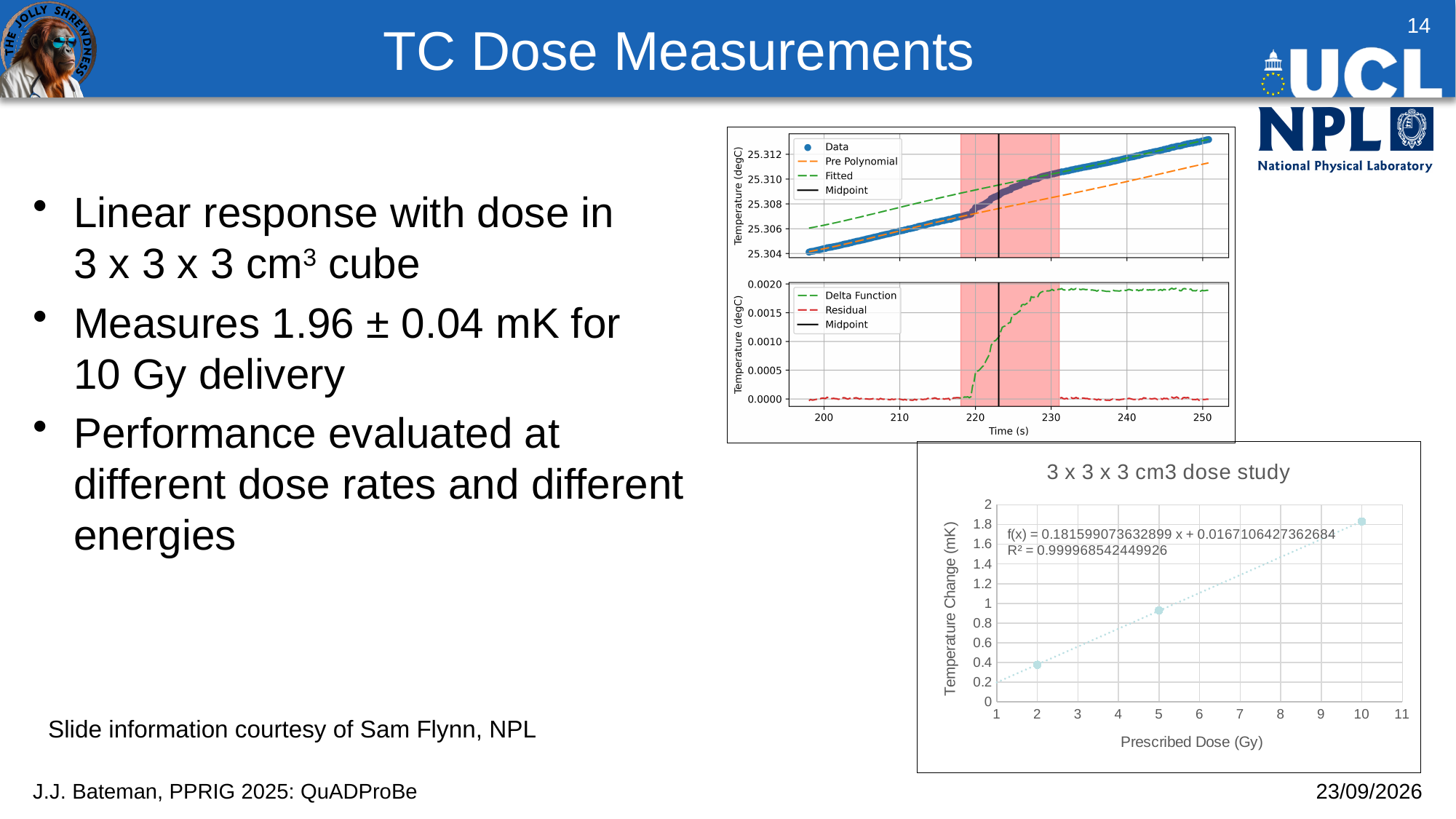
In the top-right chart (lower panel), how many entries does the legend list? 3 In the '3 x 3 x 3 cm3 dose study' chart, what is the label of the x axis? Prescribed Dose (Gy) In the '3 x 3 x 3 cm3 dose study' chart, what is the label of the y axis? Temperature Change (mK) In the '3 x 3 x 3 cm3 dose study' chart, what R² value is printed for the trendline? 0.999968542449926 In the top-right chart (upper panel, Temperature vs Time), how many entries does the legend list? 4 In the '3 x 3 x 3 cm3 dose study' chart, which prescribed dose has the highest temperature change? 10 Gy In the '3 x 3 x 3 cm3 dose study' chart, does the temperature change rise or fall as prescribed dose increases? rise In the '3 x 3 x 3 cm3 dose study' chart, which prescribed dose has the lowest temperature change? 2 Gy In the '3 x 3 x 3 cm3 dose study' chart, is the temperature change at 10 Gy greater or less than 1.6 mK? greater In the '3 x 3 x 3 cm3 dose study' chart, how many data points are plotted? 3 In the '3 x 3 x 3 cm3 dose study' chart, is the temperature change at 2 Gy greater or less than 0.6 mK? less In the '3 x 3 x 3 cm3 dose study' chart, is the temperature change at 5 Gy greater or less than 0.8 mK? greater